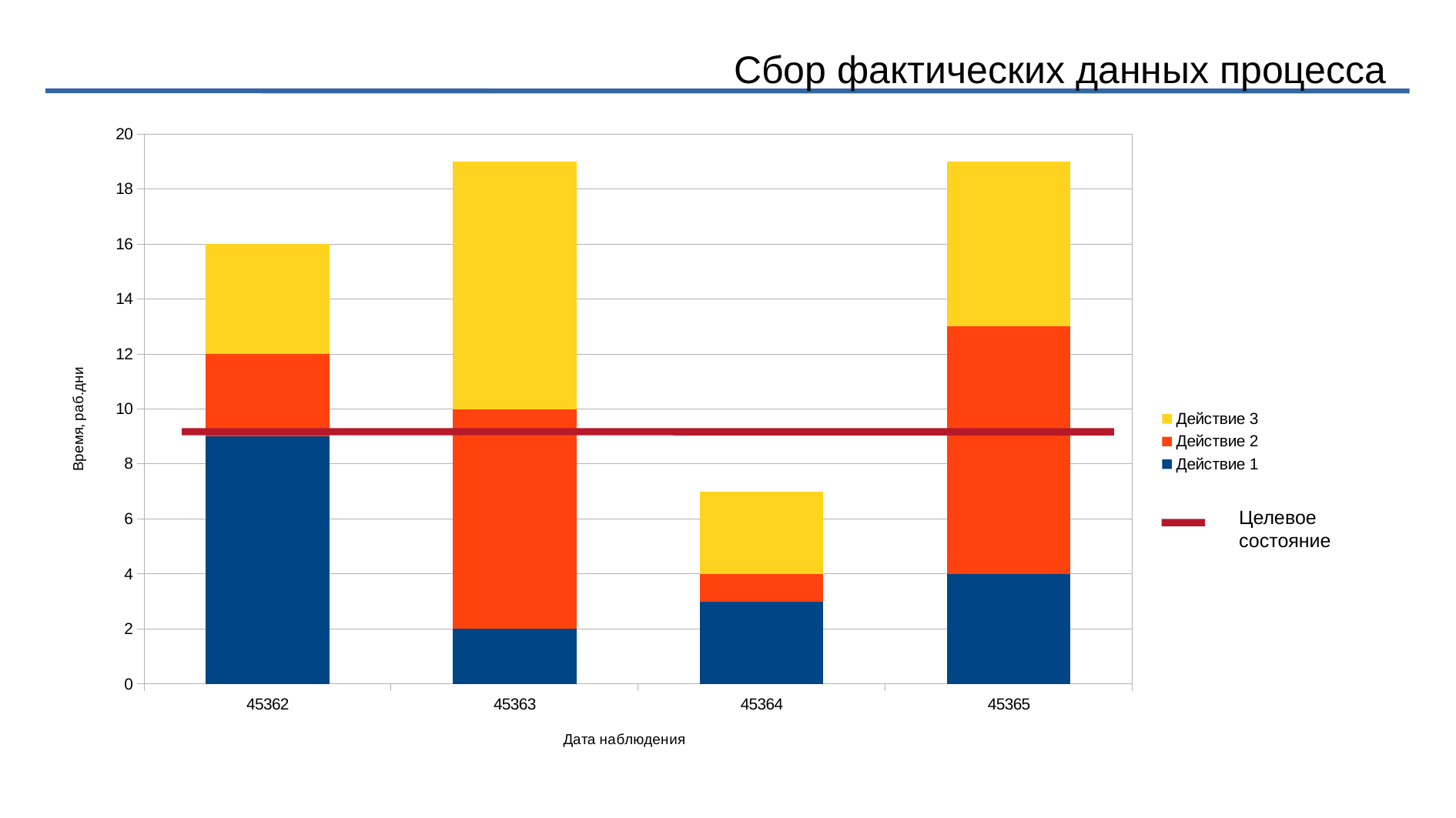
Which is larger: the total bar for 45362 or the total bar for 45364? 45362 How many dates (categories) are shown on the x axis of the chart? 4 Which date has the highest value for Действие 1? 45362 What is the total height of the stacked bar for 45362? 16 Is the total bar for 45364 greater or less than 8? less What is the label of the horizontal line shown in the legend? Целевое состояние What kind of chart is shown on the slide? Stacked bar chart Is the total bar for 45363 greater or less than 18? greater How many entries does the chart legend list? 3 What is the value of Действие 1 for 45365? 4 Which date has the lowest total stacked bar? 45364 What is the value of Действие 1 for 45363? 2